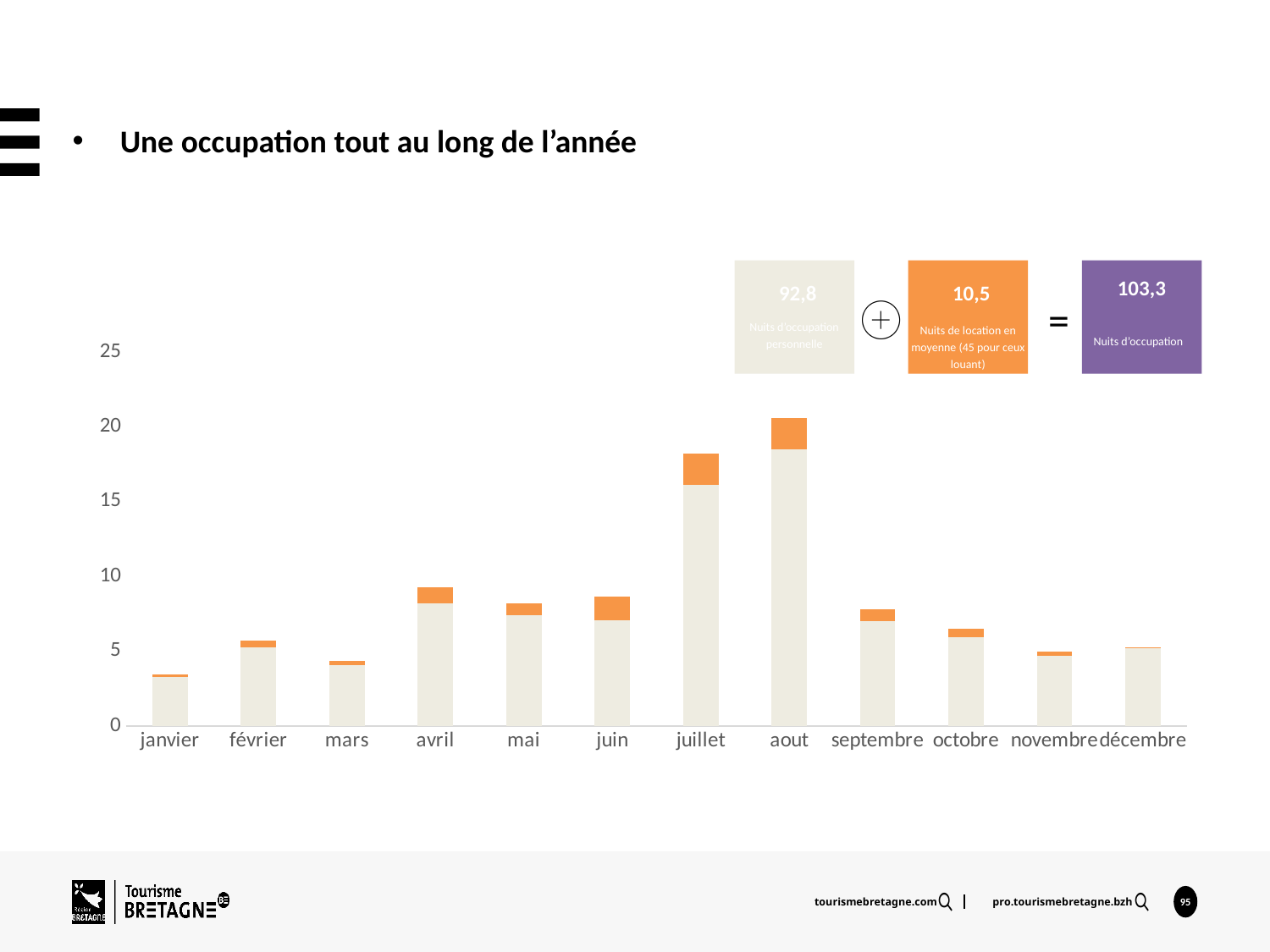
What is the title of the slide above the chart? Une occupation tout au long de l'année Which month has the highest bar in the chart? aout Is the value for janvier greater or less than 5? less How do the bar values change from janvier to aout? they rise What kind of chart is shown on the slide? stacked bar chart Which bar is taller, juillet or aout? aout Which bar is taller, janvier or février? février How many months are shown on the x axis of the chart? 12 Which month has the lowest bar in the chart? janvier Is the value for avril greater or less than 10? less Is the value for octobre greater or less than 5? greater